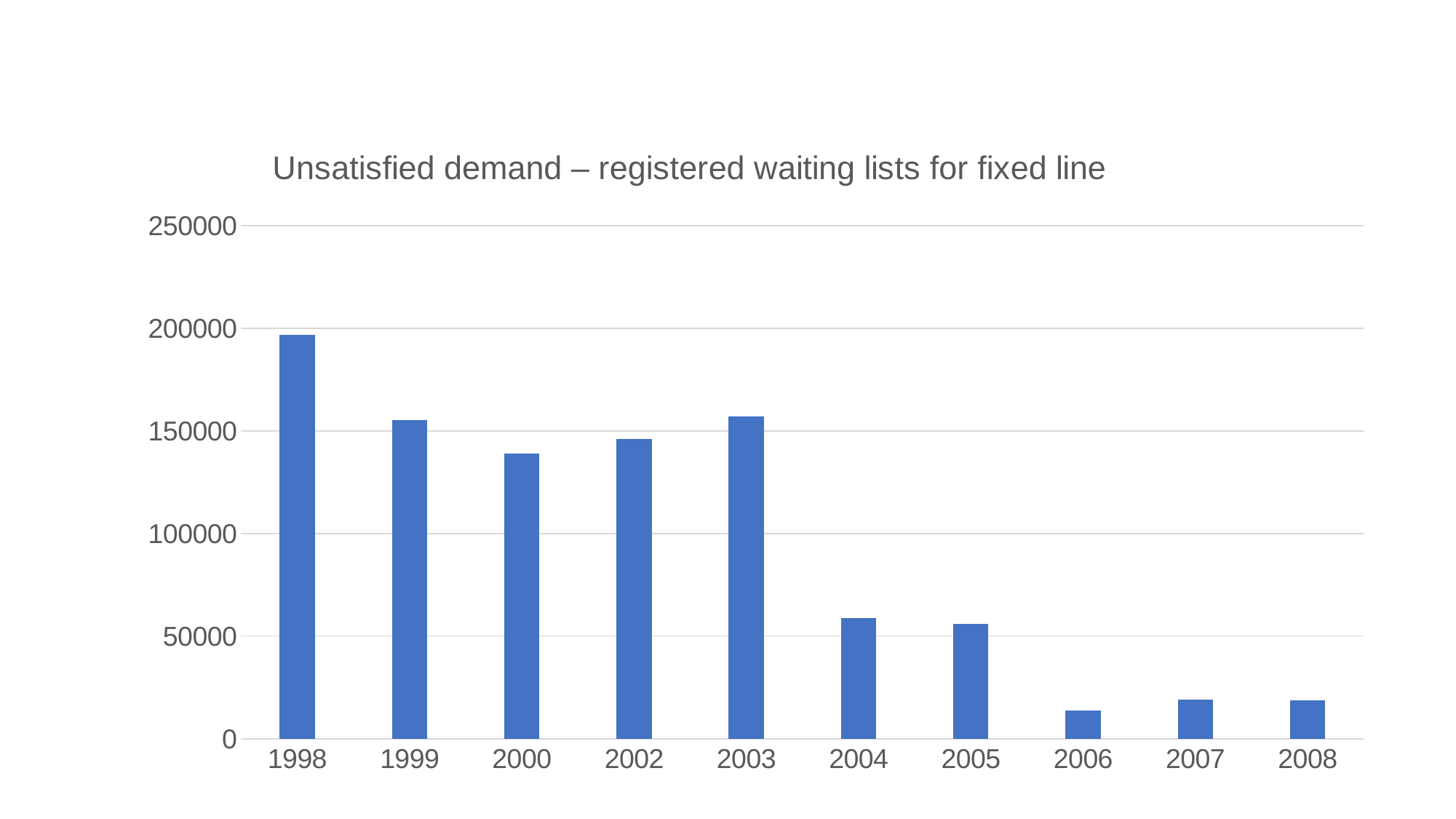
Is the value for 2006 greater or less than 50000? less What is the title of the chart? Unsatisfied demand – registered waiting lists for fixed line How many years are shown on the x axis of the chart? 10 Which year has the highest value in the chart? 1998 Is the value for 1998 greater or less than 150000? greater Which year has the larger value, 2003 or 2004? 2003 Is the value for 2004 greater or less than 50000? greater What kind of chart is shown on the slide? bar chart Overall, do the values rise or fall from 1998 to 2008? fall Which year has the lowest value in the chart? 2006 Which year has the larger value, 1999 or 2000? 1999